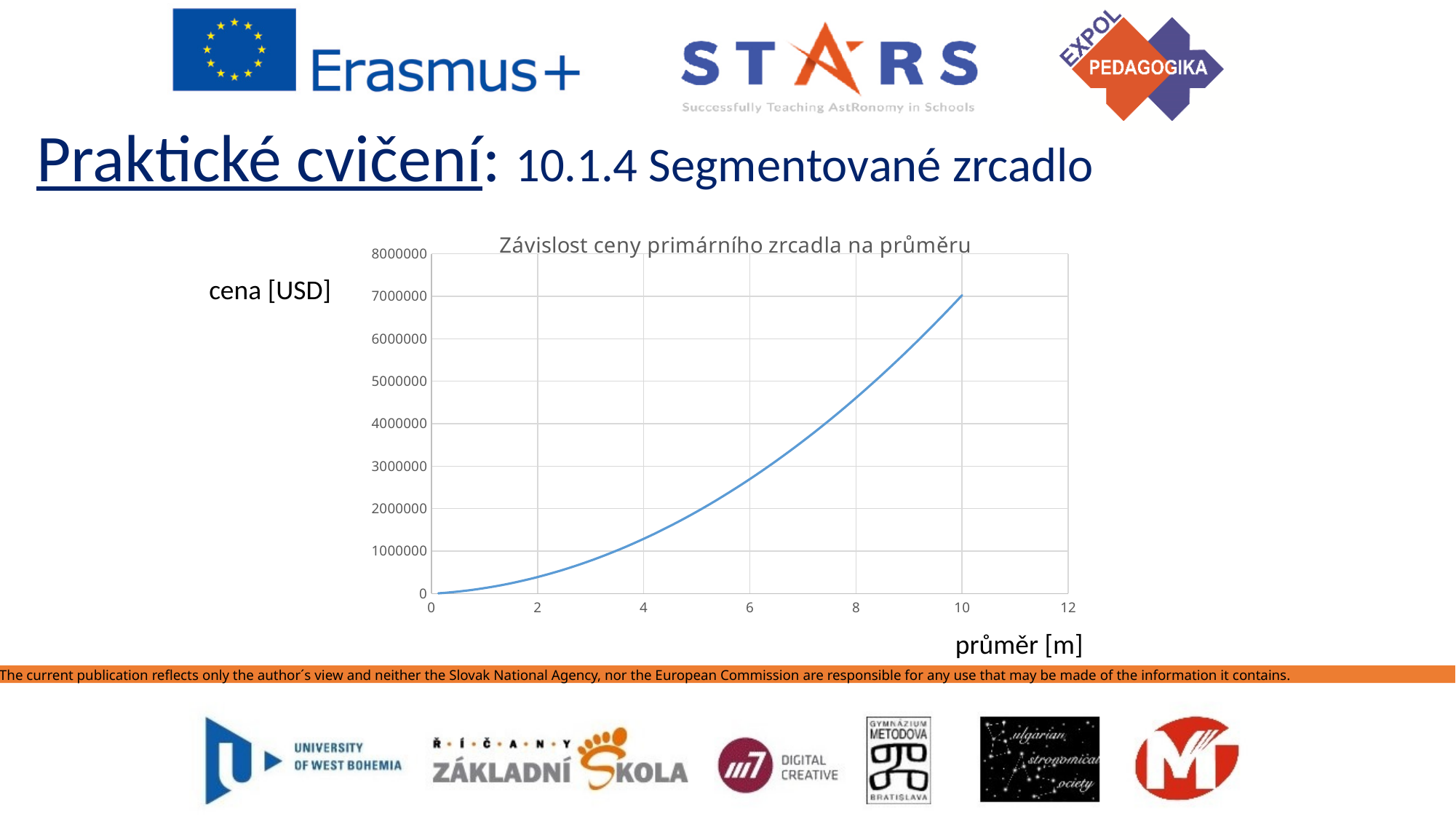
What is the label of the vertical axis of the chart? cena [USD] Is the value of the curve at a diameter of 8 m greater or less than 4000000? greater What is the title of the chart? Závislost ceny primárního zrcadla na průměru Is the value of the curve at a diameter of 8 m greater or less than 5000000? less What kind of chart is shown on the slide? line chart Which diameter has the higher price on the curve, 6 m or 10 m? 10 m Is the value of the curve at a diameter of 2 m greater or less than 1000000? less What is the highest value shown on the vertical axis of the chart? 8000000 Does the price (cena) rise or fall as the diameter (průměr) increases along the x axis? rise